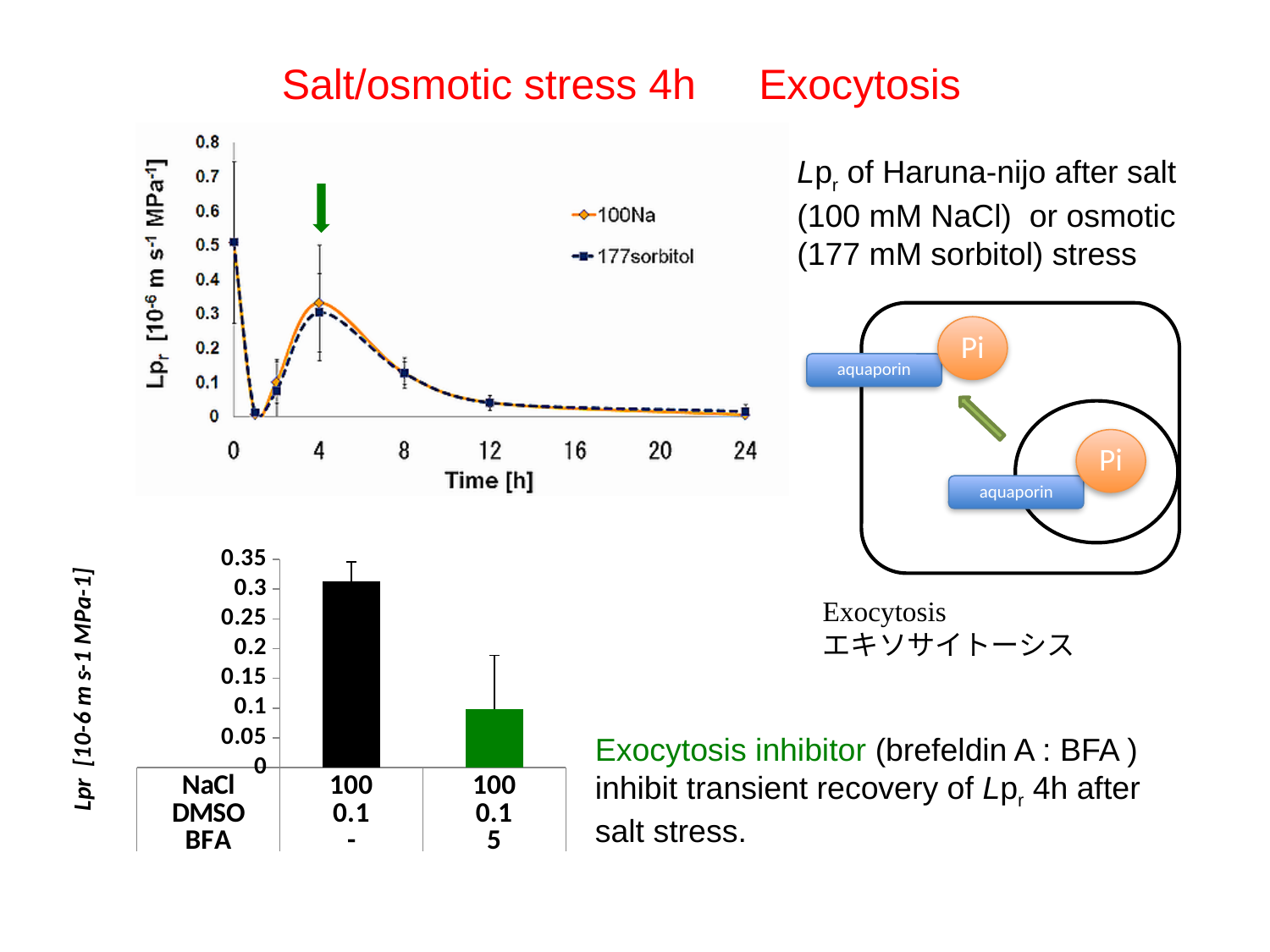
In the bottom-left bar chart, how many bars are plotted? 2 In the top-left line chart, is the 100Na value at 4 h greater or less than 0.2? greater In the top-left line chart, how many series does the legend list? 2 What kind of chart is the top-left chart showing Lpr against Time [h]? line chart In the bottom-left bar chart, which treatment has the higher Lpr: BFA '-' or BFA '5'? BFA - In the top-left line chart, is the 177sorbitol value at 12 h greater or less than 0.1? less What kind of chart is the bottom-left chart with the NaCl/DMSO/BFA table under it? bar chart In the top-left line chart, do the values rise or fall between 4 h and 24 h? fall In the bottom-left bar chart, is the value for the BFA 5 treatment greater or less than 0.15? less In the top-left line chart, what are the two legend entries? 100Na and 177sorbitol In the top-left line chart, what is the label of the x axis? Time [h]